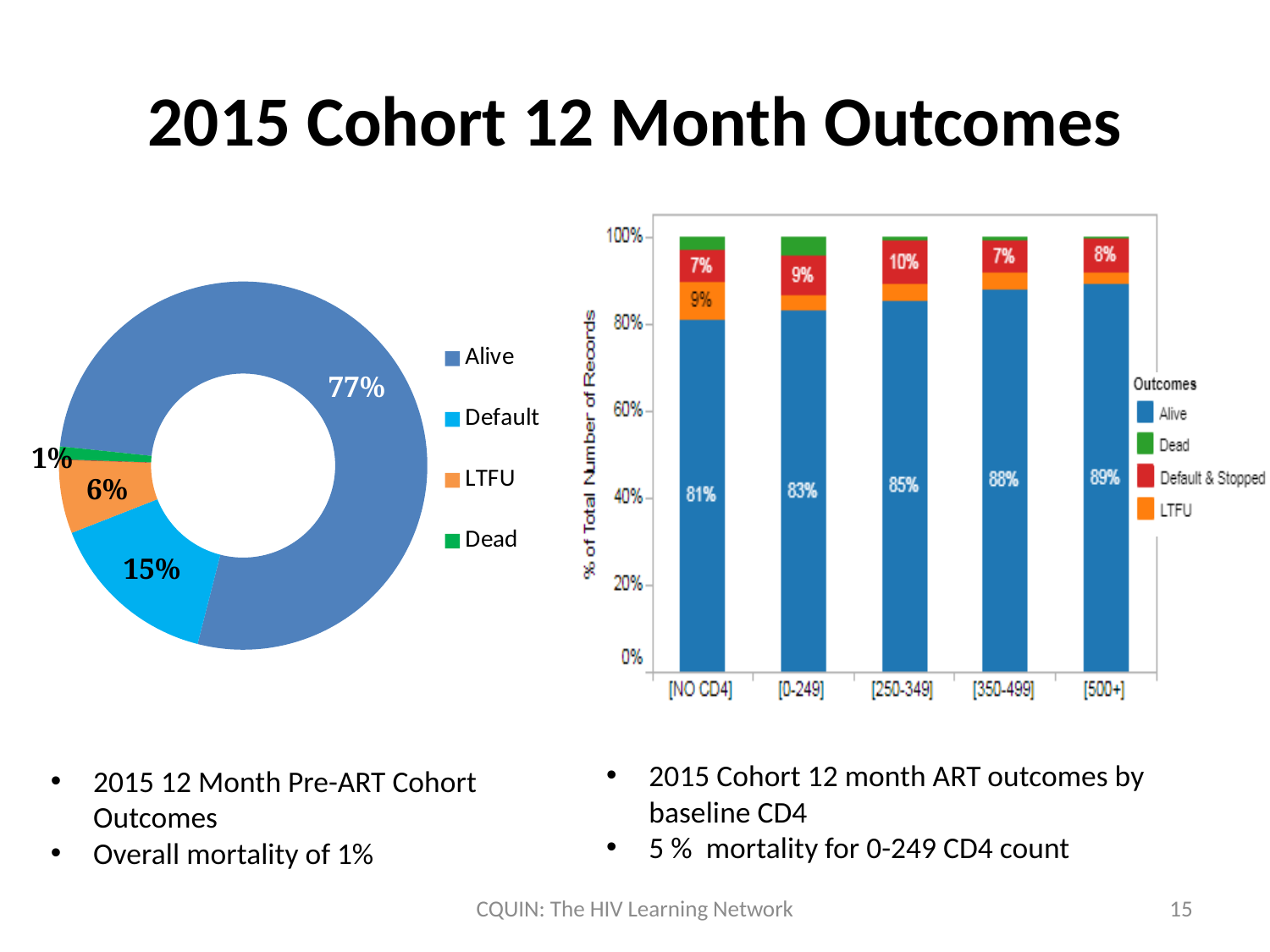
In the donut chart on the left, which outcome has the smallest share? Dead In the stacked bar chart on the right, does the Alive percentage rise or fall as baseline CD4 increases from [NO CD4] to [500+]? rise In the donut chart on the left, what percentage is Default? 15% In the stacked bar chart on the right, how many series does the Outcomes legend list? 4 In the donut chart on the left, what is the difference between the Default and LTFU shares? 9% In the stacked bar chart on the right, which baseline CD4 group has the lowest Alive percentage? [NO CD4] In the stacked bar chart on the right, what is the Alive percentage for the [0-249] baseline CD4 group? 83% In the stacked bar chart on the right, which baseline CD4 group has the highest Alive percentage? [500+] In the donut chart on the left, how many outcome categories does the legend list? 4 In the donut chart on the left, what percentage of the pre-ART cohort is Alive? 77% In the stacked bar chart on the right, what is the Alive percentage for the [500+] group? 89% In the stacked bar chart on the right, what is the Default & Stopped percentage for the [250-349] group? 10%